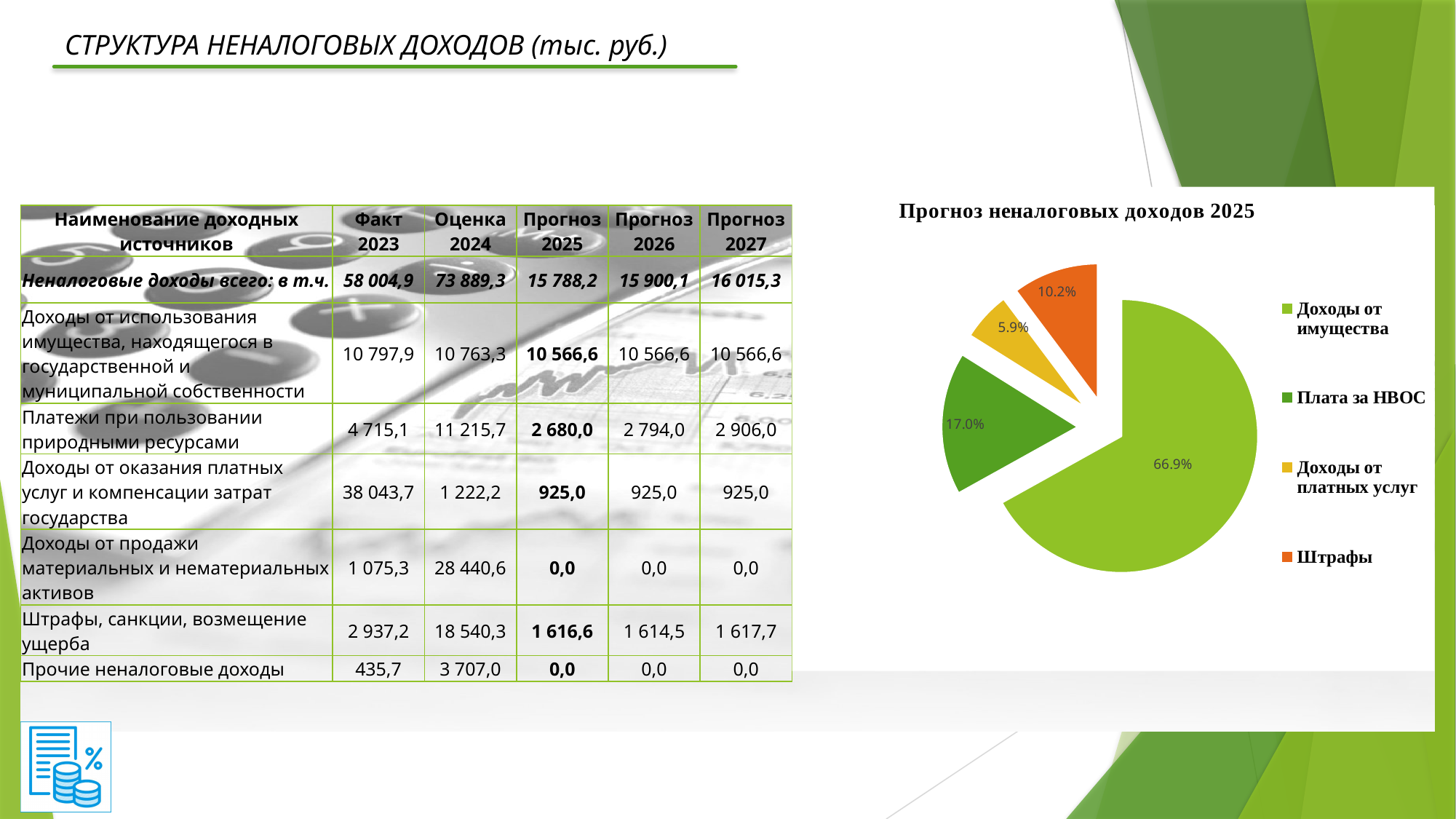
What share of the pie is labelled for Доходы от платных услуг? 5.9% How many slices does the pie chart have? 4 What type of chart is shown on the slide? pie chart What is the difference in percentage points between the Плата за НВОС slice and the Штрафы slice? 6.8 What share of the pie is labelled for Плата за НВОС? 17.0% Which category has the smallest slice of the pie? Доходы от платных услуг What share of the pie is labelled for Доходы от имущества? 66.9% Which is larger: the slice for Штрафы or the slice for Плата за НВОС? Плата за НВОС Which legend entry is shown in orange? Штрафы What is the title of the chart? Прогноз неналоговых доходов 2025 Which category has the largest slice of the pie? Доходы от имущества What share of the pie is labelled for Штрафы? 10.2%